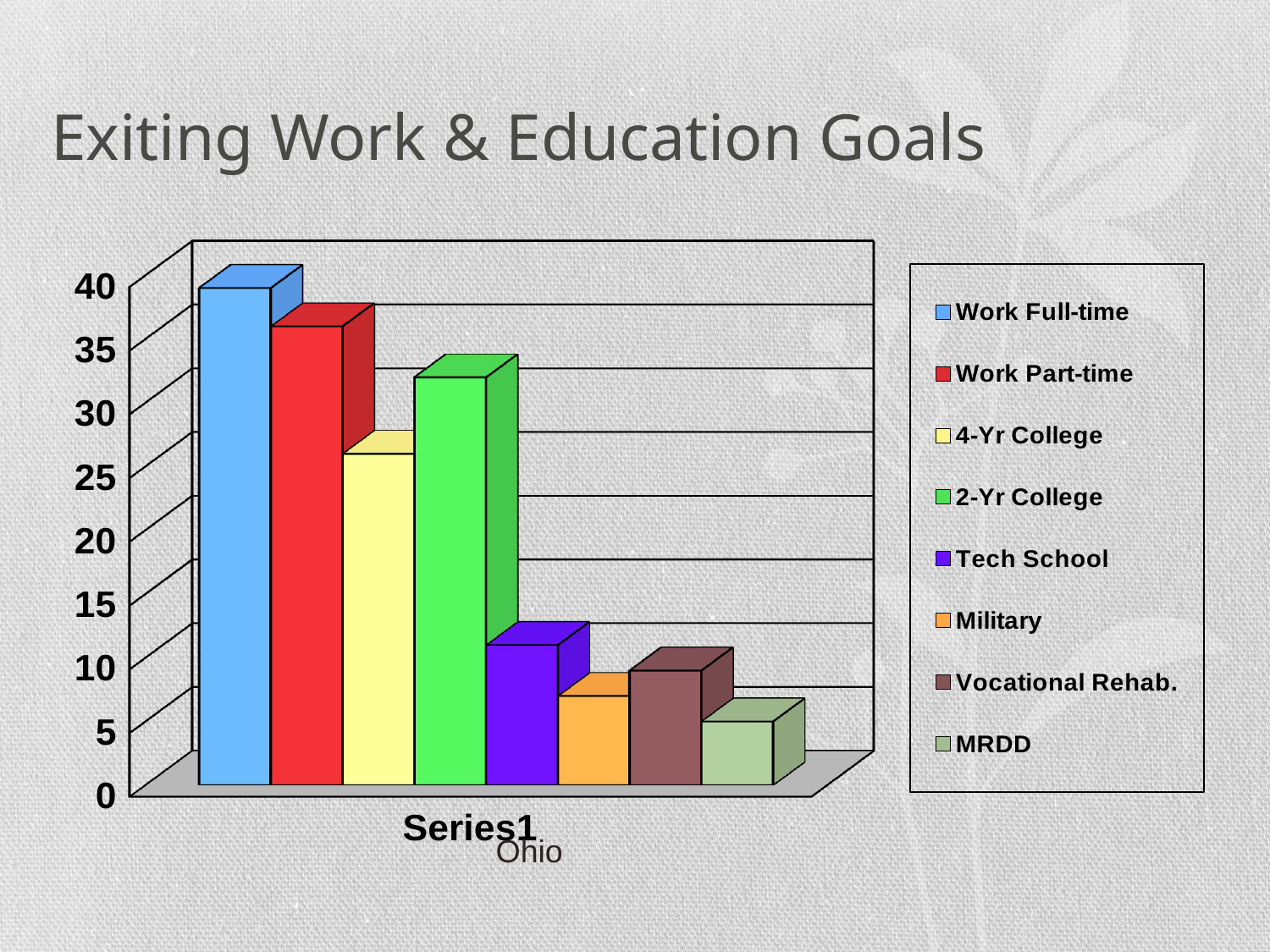
Is the value for 2-Yr College greater or less than 25? greater How many bars are plotted in the chart? 8 Which category has the highest value? Work Full-time Which category has the lowest value? MRDD Which is larger, the value for Work Full-time or the value for 4-Yr College? Work Full-time Is the value for Work Full-time greater or less than 35? greater What kind of chart is shown on the slide? bar chart Is the value for MRDD greater or less than 10? less What is the title of the slide containing the chart? Exiting Work & Education Goals Which is larger, the value for 2-Yr College or the value for Tech School? 2-Yr College